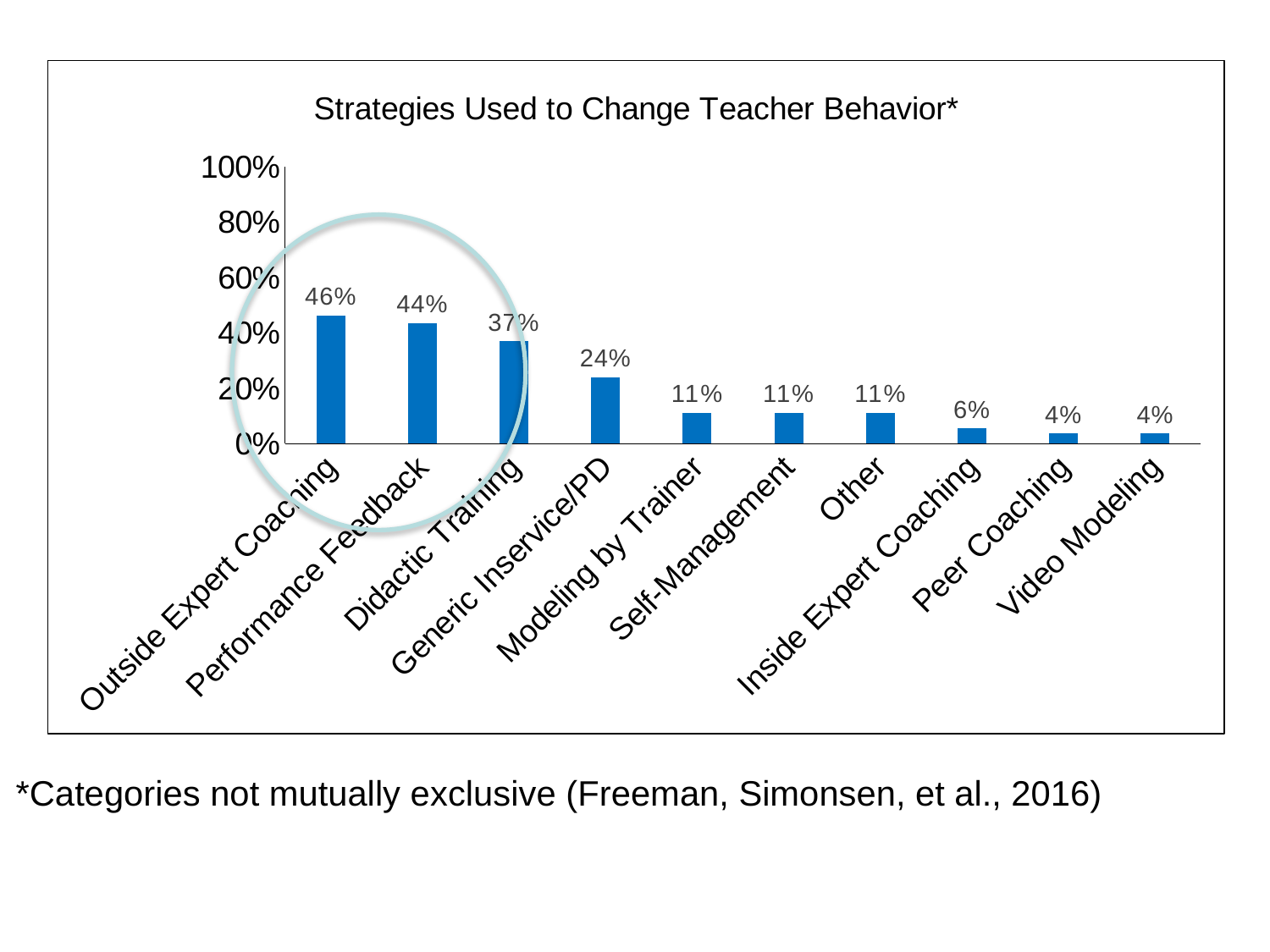
What is the value for Inside Expert Coaching? 6% What is the difference between Outside Expert Coaching and Performance Feedback? 2% What is the title of the chart? Strategies Used to Change Teacher Behavior* What is the value for Generic Inservice/PD? 24% How many categories are shown on the x axis? 10 Which category has the highest value? Outside Expert Coaching Which is larger, Performance Feedback or Didactic Training? Performance Feedback What kind of chart is this? bar chart What is the difference between Didactic Training and Generic Inservice/PD? 13% Is the value for Generic Inservice/PD greater or less than 20%? greater Do the values generally rise or fall from left to right along the x axis? fall What is the value for Outside Expert Coaching? 46%